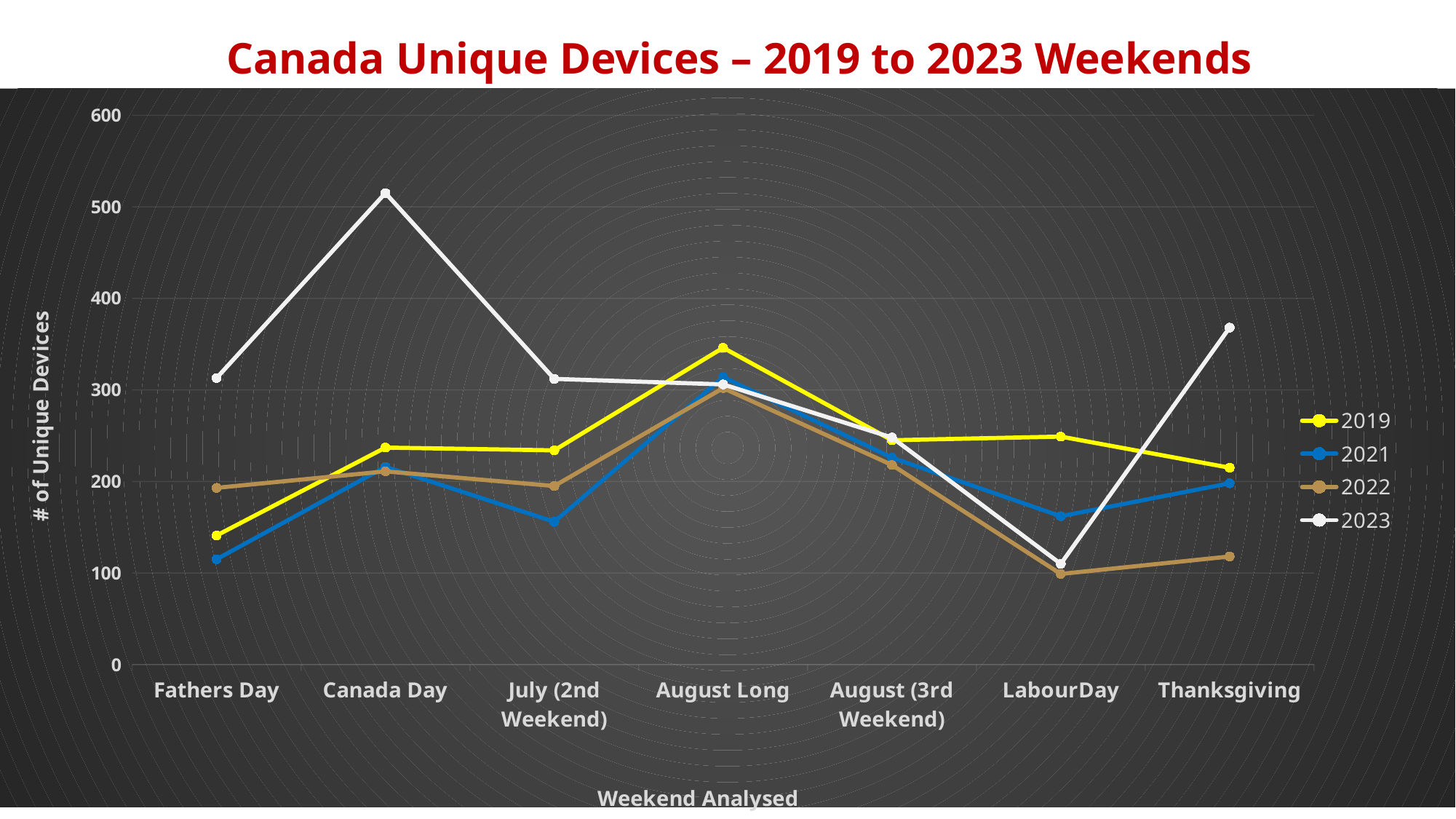
For the 2021 series, which weekend has the lowest number of unique devices? Fathers Day On Fathers Day, which series has the larger value, 2019 or 2023? 2023 What is the title of the x axis? Weekend Analysed What kind of chart is shown on the slide? line chart Is the 2023 value for Canada Day greater or less than 400? greater For the 2019 series, which weekend has the highest number of unique devices? August Long For the 2022 series, which weekend has the lowest number of unique devices? LabourDay Does the 2022 series rise or fall from August Long to LabourDay? fall For the 2023 series, which weekend has the highest number of unique devices? Canada Day Is the 2022 value for Thanksgiving greater or less than 200? less How many series does the legend list? 4 How many weekends are plotted along the x axis? 7